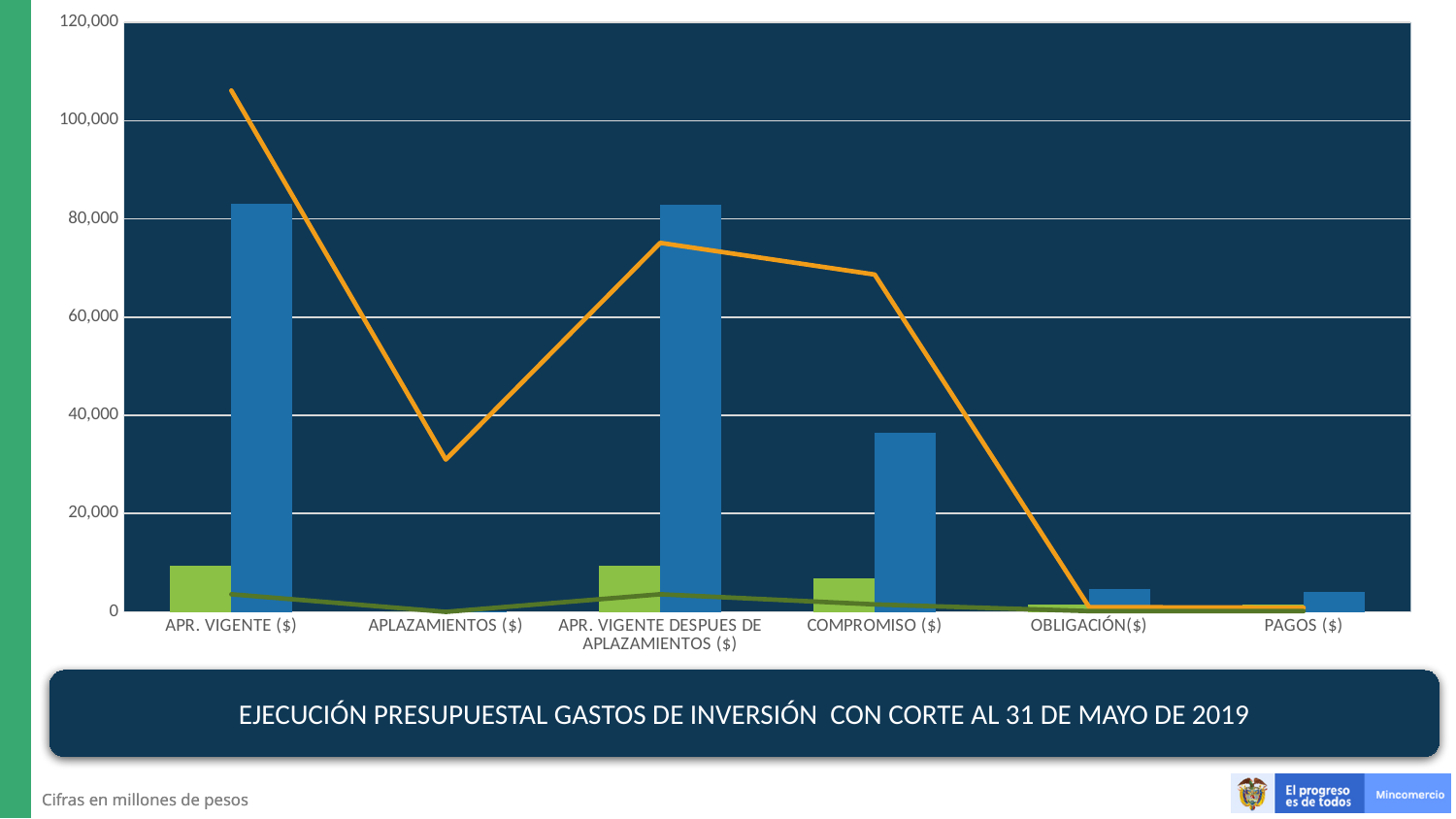
What is the highest value shown on the vertical axis of the chart? 120,000 Is the value of the blue bar at OBLIGACIÓN($) greater or less than 20,000? less At which category does the orange line reach its highest value? APR. VIGENTE ($) Is the value of the orange line at APLAZAMIENTOS ($) greater or less than 40,000? less Is the value of the orange line at APR. VIGENTE ($) greater or less than 100,000? greater Which has the larger blue bar, COMPROMISO ($) or OBLIGACIÓN($)? COMPROMISO ($) What kind of chart is shown on the slide? Combined bar and line chart How many categories are shown along the x axis of the chart? 6 Does the orange line rise or fall from COMPROMISO ($) to OBLIGACIÓN($)? fall